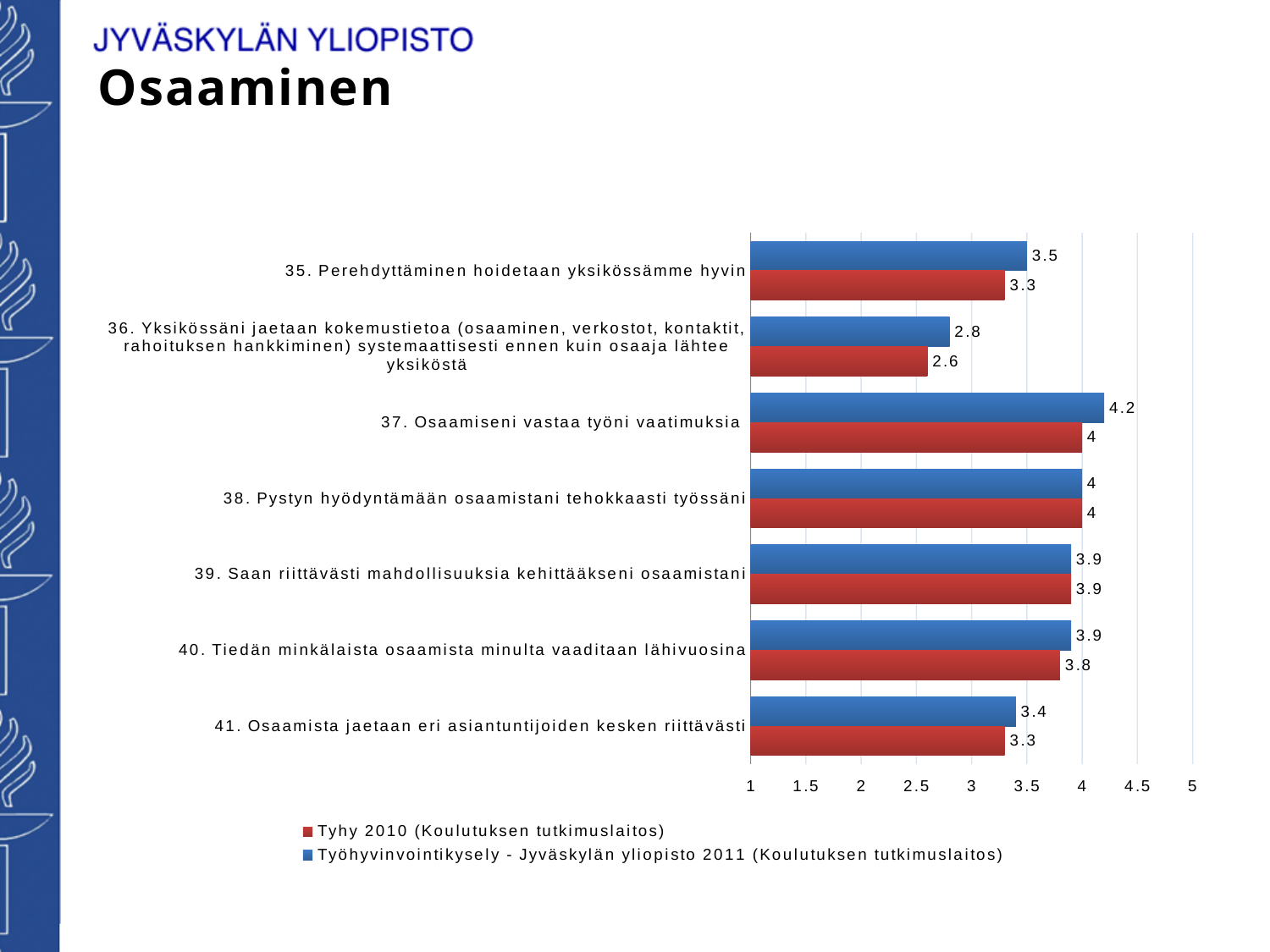
Is the Tyhy 2010 value for item 36 greater or less than 3? less Which item has the highest value in the Työhyvinvointikysely 2011 series? 37. Osaamiseni vastaa työni vaatimuksia What kind of chart is shown on the slide? bar chart What is the value for item 41 (Osaamista jaetaan eri asiantuntijoiden kesken riittävästi) in the Työhyvinvointikysely 2011 series? 3.4 For item 40, which series has the larger value, Tyhy 2010 or Työhyvinvointikysely 2011? Työhyvinvointikysely 2011 How many survey items (categories) are shown in the chart? 7 What is the value for item 36 in the Tyhy 2010 series? 2.6 Which colour represents the Tyhy 2010 series? red What is the value for item 37 (Osaamiseni vastaa työni vaatimuksia) in the Työhyvinvointikysely 2011 series? 4.2 How many series does the legend list? 2 What is the difference between the 2011 and 2010 values for item 35 (Perehdyttäminen hoidetaan yksikössämme hyvin)? 0.2 Which item has the lowest value in the Tyhy 2010 series? 36. Yksikössäni jaetaan kokemustietoa (osaaminen, verkostot, kontaktit, rahoituksen hankkiminen) systemaattisesti ennen kuin osaaja lähtee yksiköstä